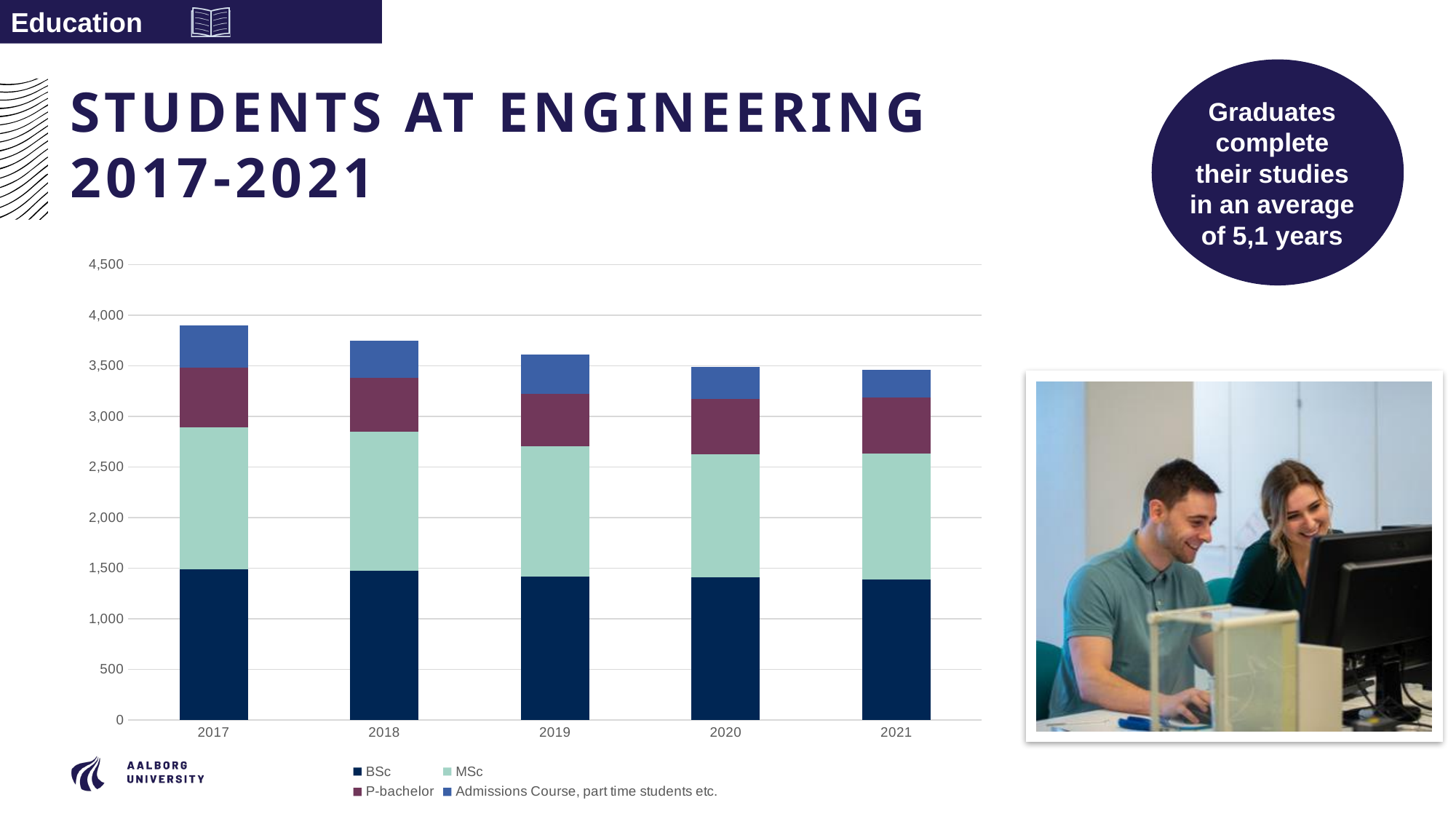
Do the total bar heights rise or fall from 2017 to 2021? fall How many series does the chart legend list? 4 Is the BSc value for 2021 greater or less than 1,500? less What kind of chart is shown on the slide? stacked bar chart Is the total for 2020 greater or less than 4,000? less Which year has the highest total number of students in the chart? 2017 How many years are shown on the x axis of the chart? 5 Is the total for 2017 greater or less than 3,500? greater Which is larger, the total for 2017 or the total for 2020? 2017 What is the title of the slide containing the chart? STUDENTS AT ENGINEERING 2017-2021 Which series is shown in the dark navy colour at the bottom of each bar? BSc